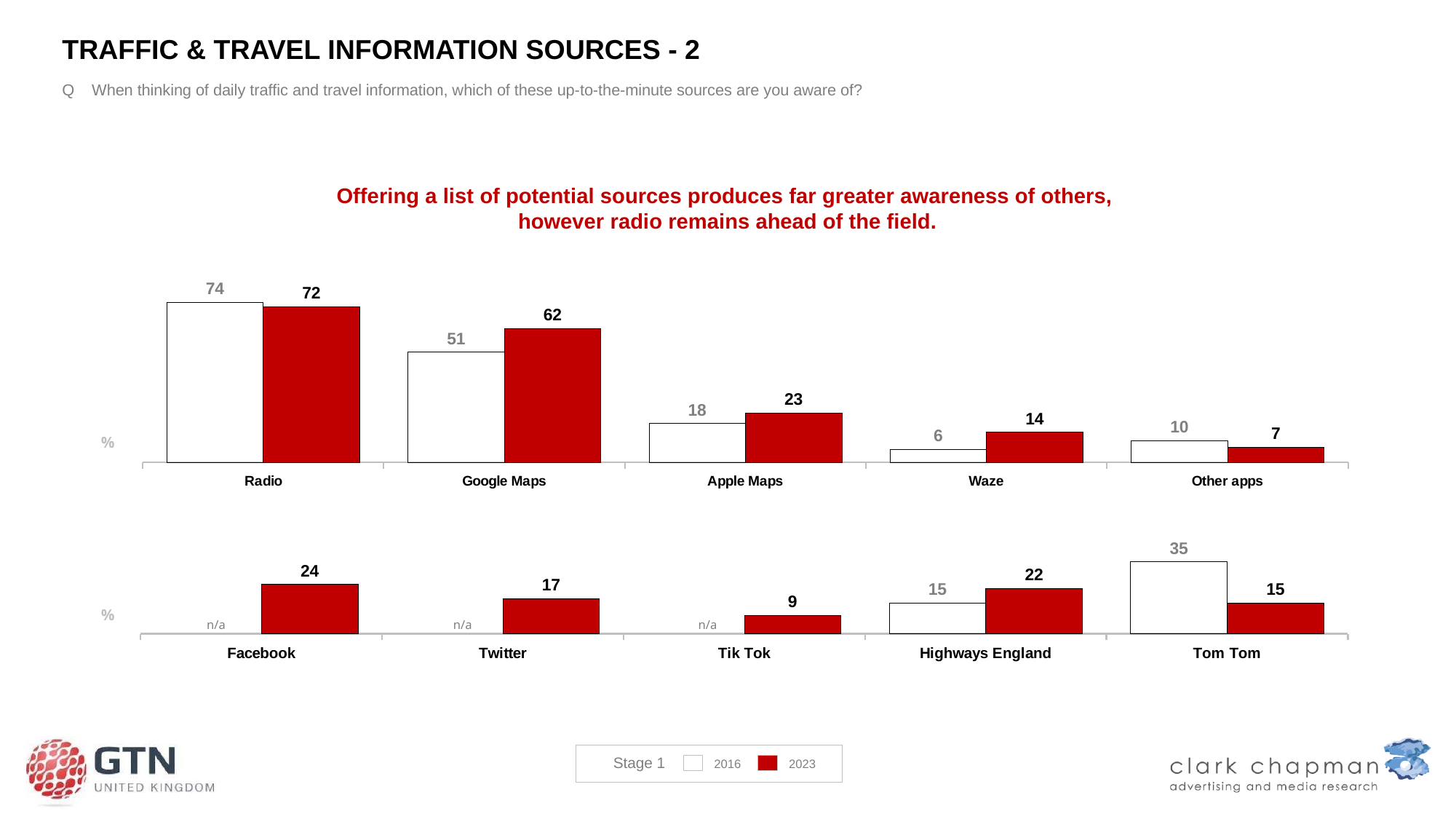
In the bottom chart, what is the 2023 value for Tik Tok? 9 How many categories are shown in the bottom chart? 5 In the top chart, which category has the highest 2023 value? Radio In the bottom chart, which category has the lowest 2023 value? Tik Tok How many series does the legend list? 2 What type of chart is used on this slide? Bar chart In the top chart, what is the 2016 value for Waze? 6 In the bottom chart, what is the difference between the 2016 and 2023 values for Tom Tom? 20 In the bottom chart, what is the 2016 value for Tom Tom? 35 In the top chart, which is larger for Other apps: the 2016 value or the 2023 value? 2016 In the top chart, what is the 2023 value for Google Maps? 62 In the top chart, what is the difference between the 2023 and 2016 values for Google Maps? 11